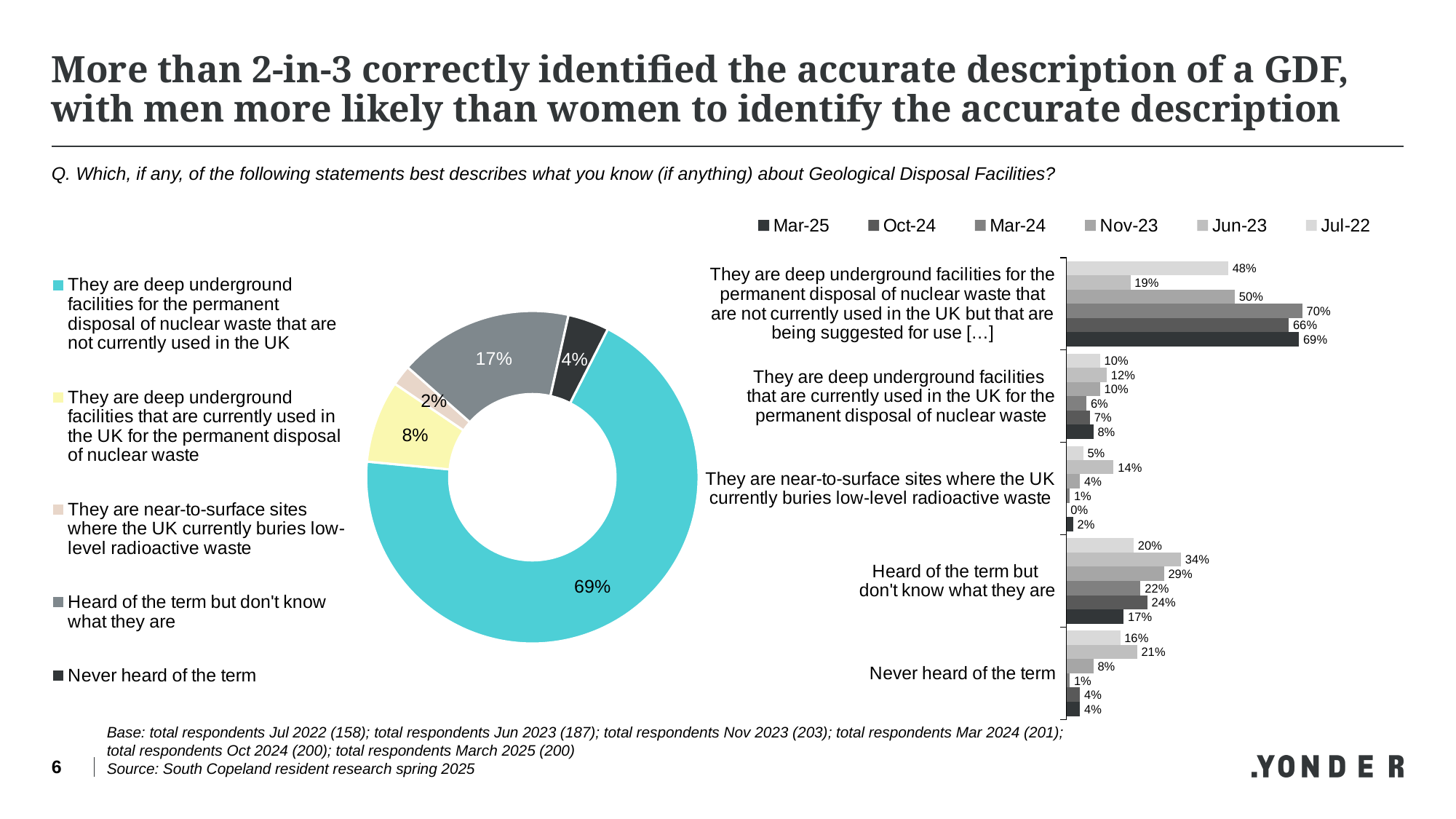
What kind of chart is the chart on the right of the slide? Bar chart How many categories are shown in the bar chart on the right? 5 In the bar chart on the right, what is the difference between the Mar-24 and Jun-23 values for the first category (deep underground facilities not currently used in the UK)? 51 percentage points In the bar chart on the right, what is the Jul-22 value for 'Never heard of the term'? 16% In the donut chart, which category has the largest slice? They are deep underground facilities for the permanent disposal of nuclear waste that are not currently used in the UK In the donut chart, what share is shown for 'Heard of the term but don't know what they are'? 17% In the bar chart on the right, which is larger for 'Never heard of the term': the Jun-23 value or the Nov-23 value? Jun-23 How many series does the legend of the bar chart on the right list? 6 In the bar chart on the right, what is the Mar-24 value for 'Heard of the term but don't know what they are'? 22% What kind of chart is the chart on the left of the slide? Donut (pie) chart In the bar chart on the right, which series has the lowest value for 'They are near-to-surface sites where the UK currently buries low-level radioactive waste'? Oct-24 In the donut chart, which category has the smallest slice? They are near-to-surface sites where the UK currently buries low-level radioactive waste